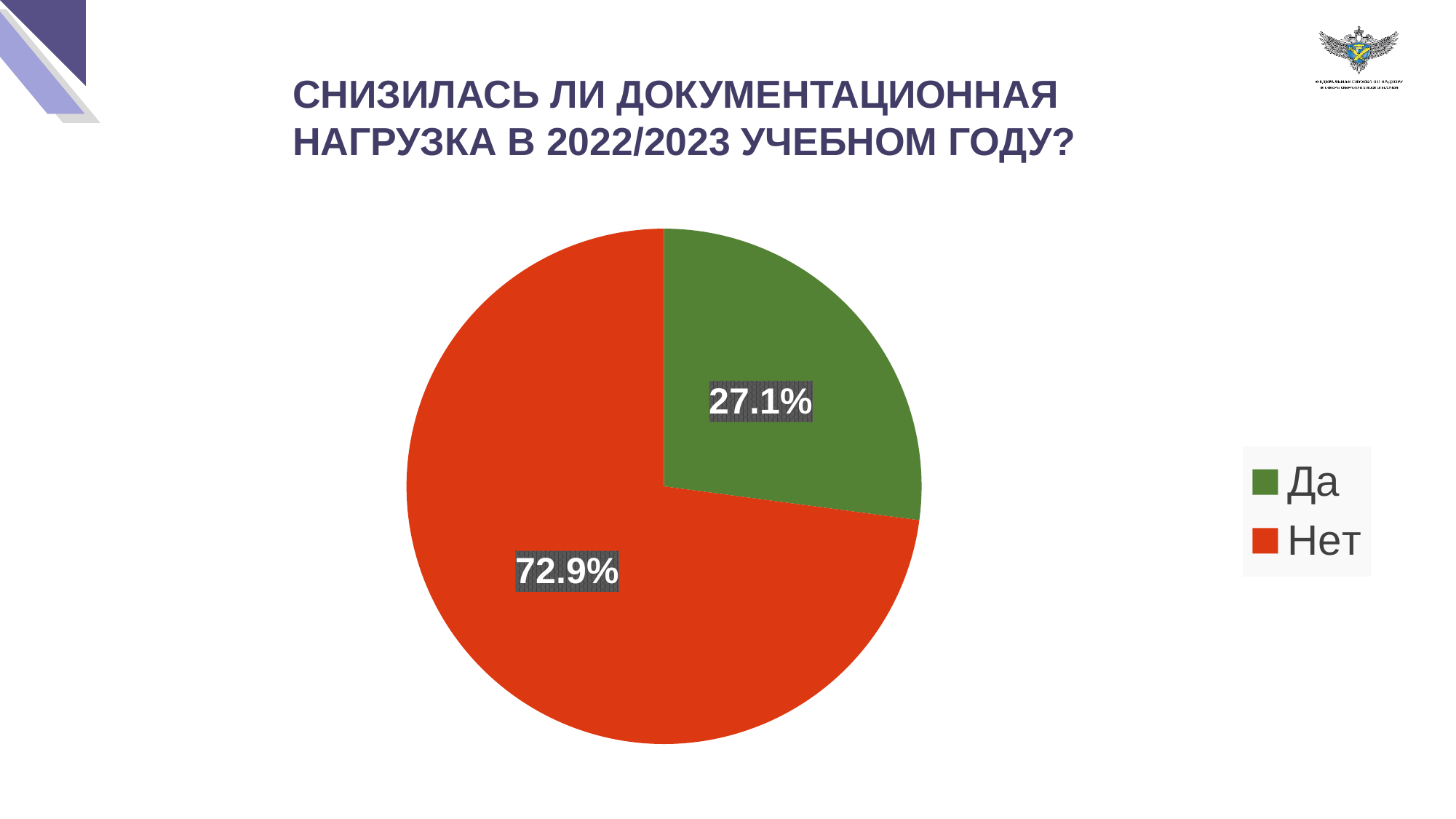
How many slices does the pie chart have? 2 How many entries does the legend list? 2 What share of respondents answered "Да"? 27.1% Which answer has the largest slice of the pie? Нет What colour is the "Нет" slice? red What is the difference in percentage points between the "Нет" and "Да" slices? 45.8 What kind of chart is shown on the slide? pie chart Which answer has the smallest slice of the pie? Да What colour is the "Да" slice? green Which slice is larger, "Да" or "Нет"? Нет What share of respondents answered "Нет"? 72.9%